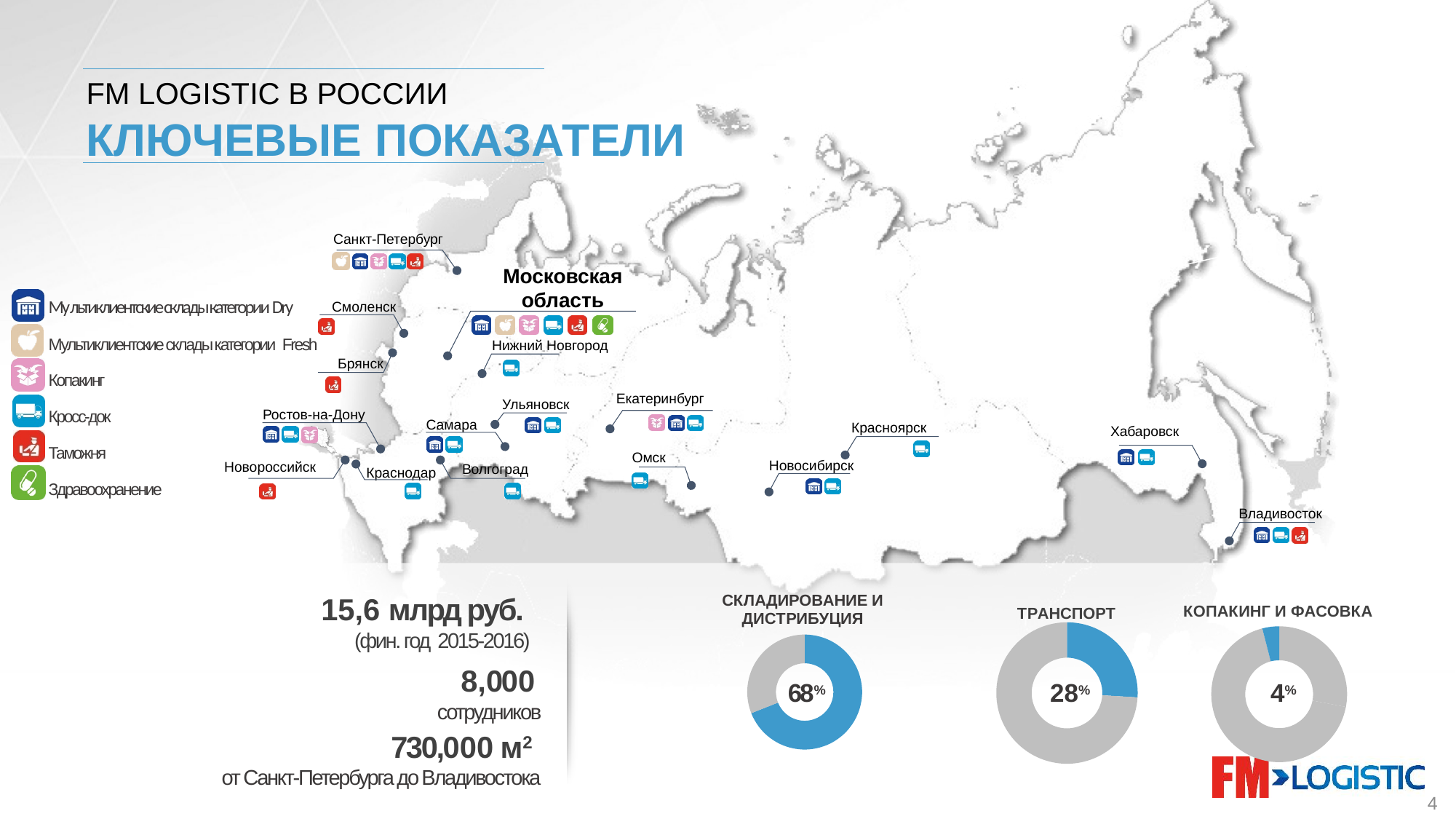
What kind of chart is used for "СКЛАДИРОВАНИЕ И ДИСТРИБУЦИЯ", "ТРАНСПОРТ" and "КОПАКИНГ И ФАСОВКА"? Donut (pie) chart What is the difference between the percentage in the "ТРАНСПОРТ" chart and the percentage in the "КОПАКИНГ И ФАСОВКА" chart? 24% Which of the three donut charts at the bottom of the slide shows the highest percentage? СКЛАДИРОВАНИЕ И ДИСТРИБУЦИЯ Which of the three donut charts at the bottom of the slide shows the lowest percentage? КОПАКИНГ И ФАСОВКА What percentage is shown in the donut chart titled "СКЛАДИРОВАНИЕ И ДИСТРИБУЦИЯ"? 68% In the "ТРАНСПОРТ" donut chart, what colour is the slice representing 28%? Blue What do the percentages in the three donut charts add up to? 100% What is the difference between the percentage in the "СКЛАДИРОВАНИЕ И ДИСТРИБУЦИЯ" chart and the percentage in the "ТРАНСПОРТ" chart? 40% Which is larger: the percentage in the "ТРАНСПОРТ" chart or the percentage in the "КОПАКИНГ И ФАСОВКА" chart? ТРАНСПОРТ How many donut charts are shown at the bottom of the slide? 3 What percentage is shown in the donut chart titled "КОПАКИНГ И ФАСОВКА"? 4% What percentage is shown in the donut chart titled "ТРАНСПОРТ"? 28%